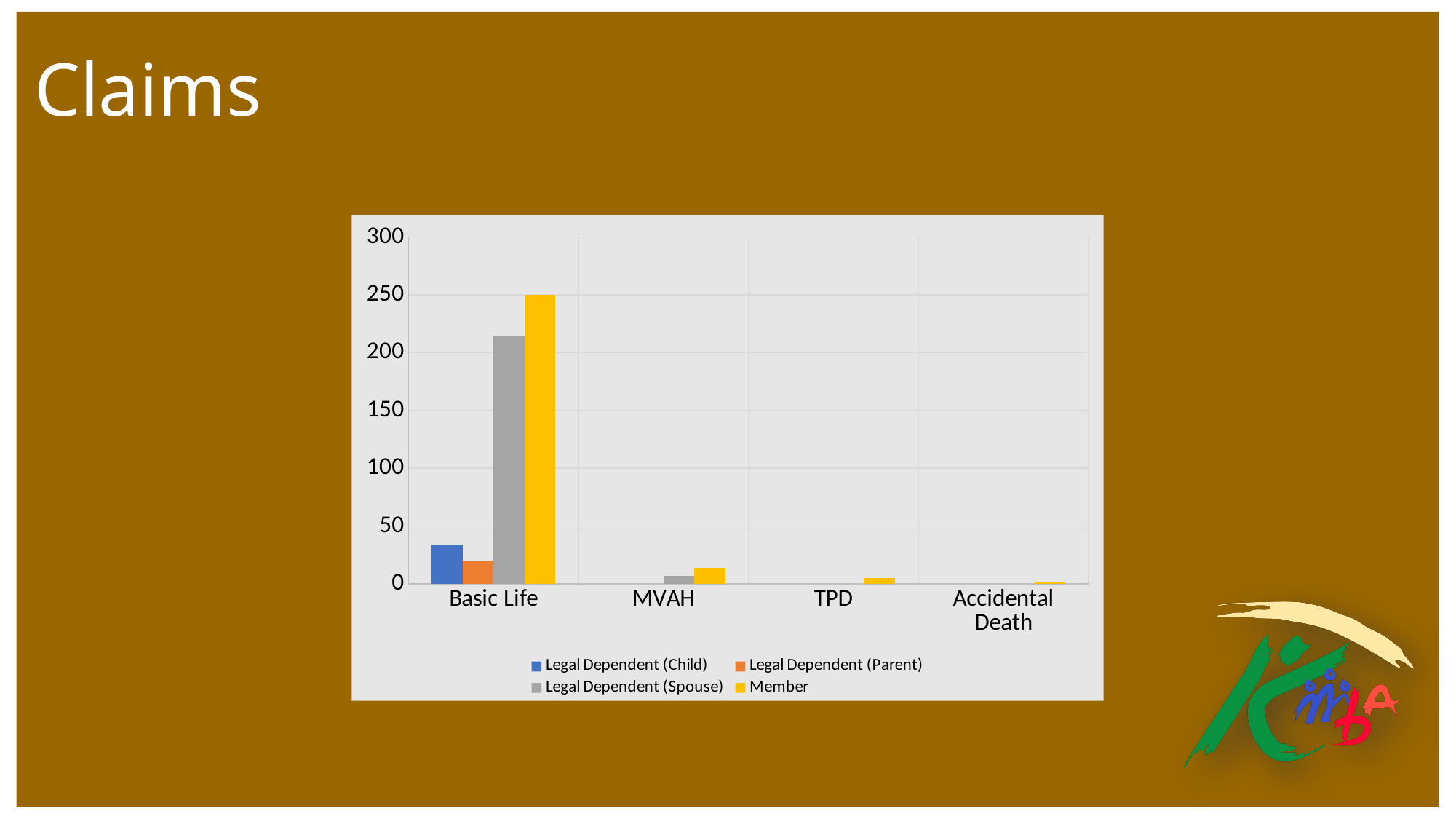
What kind of chart is shown on the slide? bar chart Is the Legal Dependent (Child) value for Basic Life greater or less than 50? less How many categories are shown on the x axis of the chart? 4 How many series does the chart's legend list? 4 Is the Member value for Basic Life greater or less than 200? greater Do the Member values rise or fall moving from Basic Life to Accidental Death along the x axis? fall Which category has the highest value for the Member series? Basic Life For Basic Life, which is larger: the Member value or the Legal Dependent (Spouse) value? Member What is the title of the slide containing the chart? Claims Is the Member value for MVAH greater or less than 50? less For Basic Life, which is larger: the Legal Dependent (Child) value or the Legal Dependent (Parent) value? Legal Dependent (Child)